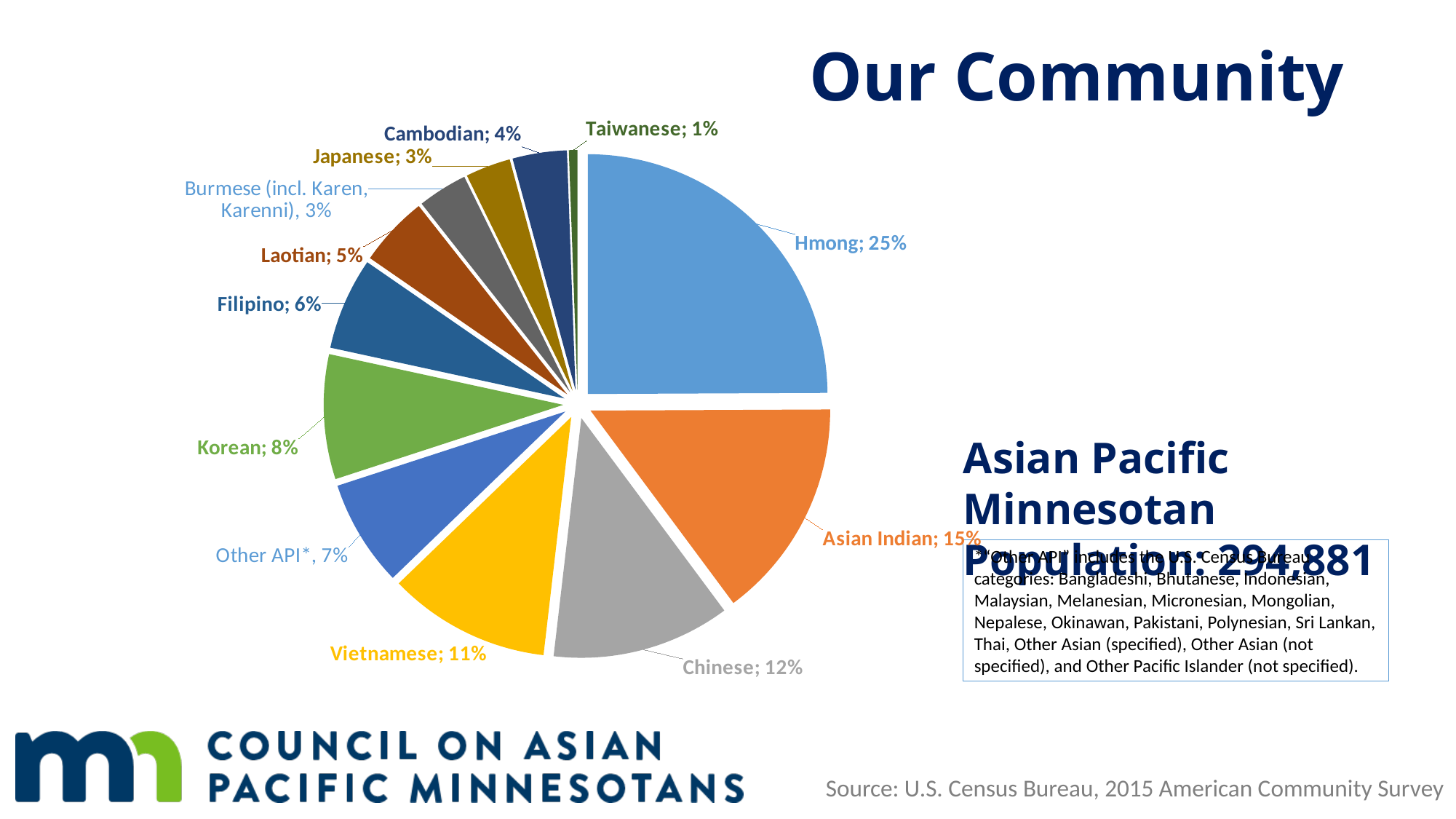
What share of the pie does Hmong represent? 25% What is the difference in percentage points between Hmong and Vietnamese? 14 Which is larger, the Korean slice or the Filipino slice? Korean What percentage is shown for Burmese (incl. Karen, Karenni)? 3% What is the title of the slide containing the chart? Our Community Which group has the largest slice of the pie? Hmong What is the difference in percentage points between Asian Indian and Chinese? 3 Which group has the smallest slice of the pie? Taiwanese What type of chart is shown on the slide? Pie chart Which is larger, the Laotian slice or the Other API* slice? Other API* How many groups are shown in the pie chart? 12 What percentage is shown for Vietnamese? 11%